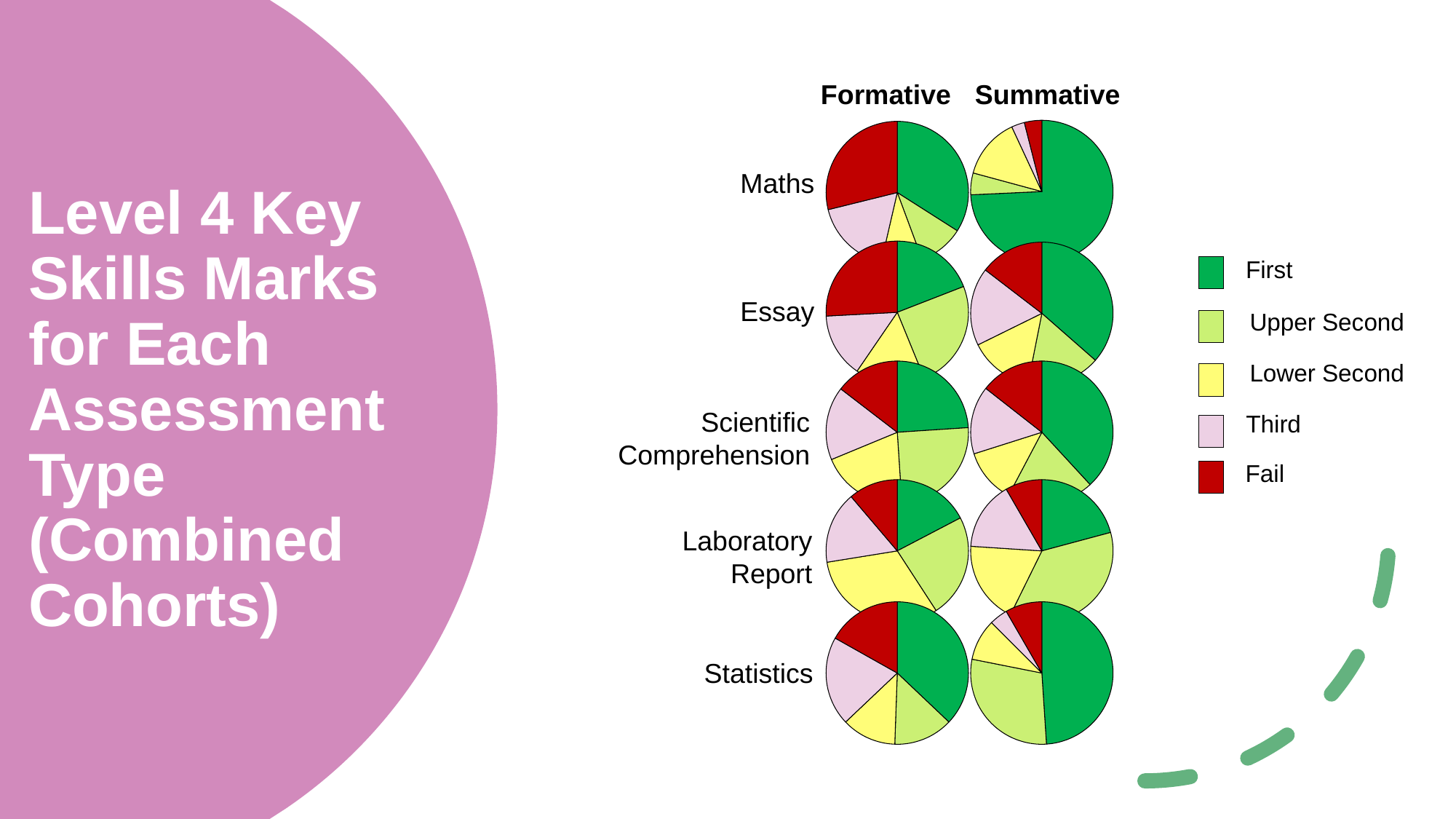
What kind of charts are shown on the slide? Pie charts In the Scientific Comprehension Summative pie chart, which category has the largest slice? First In the Maths Summative pie chart, which category has the smallest slice? Third Which legend category is shown in red? Fail What are the two column headings above the pie charts? Formative and Summative Is the Fail slice larger in the Maths Formative pie chart or the Maths Summative pie chart? Maths Formative How many categories does the legend list? 5 In the Statistics Summative pie chart, which category has the largest slice? First How many assessment types are listed down the left of the pie charts? 5 Is the First slice larger in the Maths Formative pie chart or the Maths Summative pie chart? Maths Summative In the Maths Summative pie chart, which category has the largest slice? First How many pie charts are shown on the slide? 10